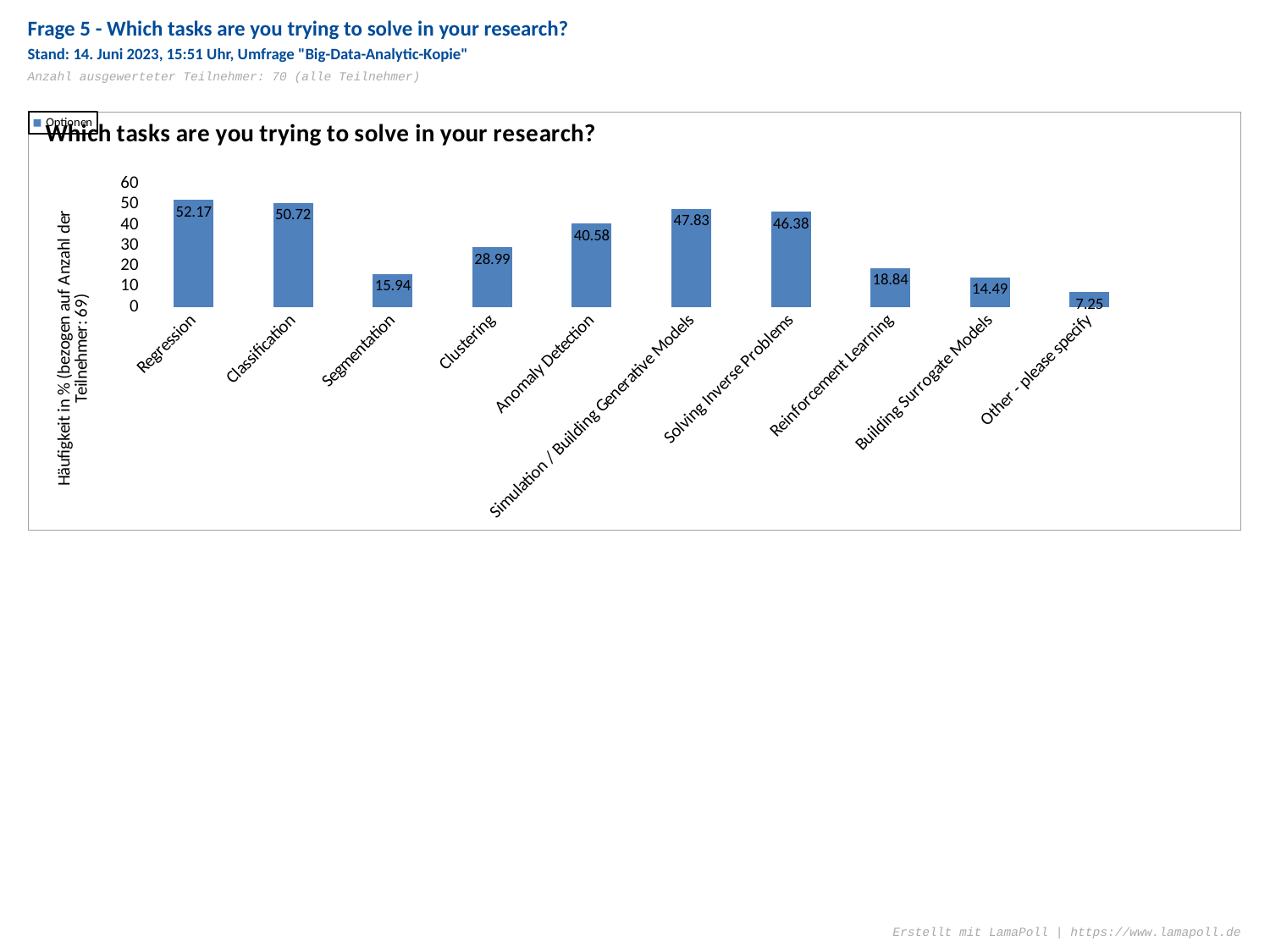
What is the value for Simulation / Building Generative Models? 47.83 What kind of chart is shown on the slide? bar chart What is the value for Regression? 52.17 What is the difference between the values for Classification and Segmentation? 34.78 What is the title of the chart? Which tasks are you trying to solve in your research? What is the value for Building Surrogate Models? 14.49 Which category has the lowest value? Other - please specify How many categories are shown on the x axis? 10 Is the value for Solving Inverse Problems greater or less than 40? greater Which category has the highest value? Regression What is the value for Anomaly Detection? 40.58 Which is larger, the value for Clustering or the value for Reinforcement Learning? Clustering